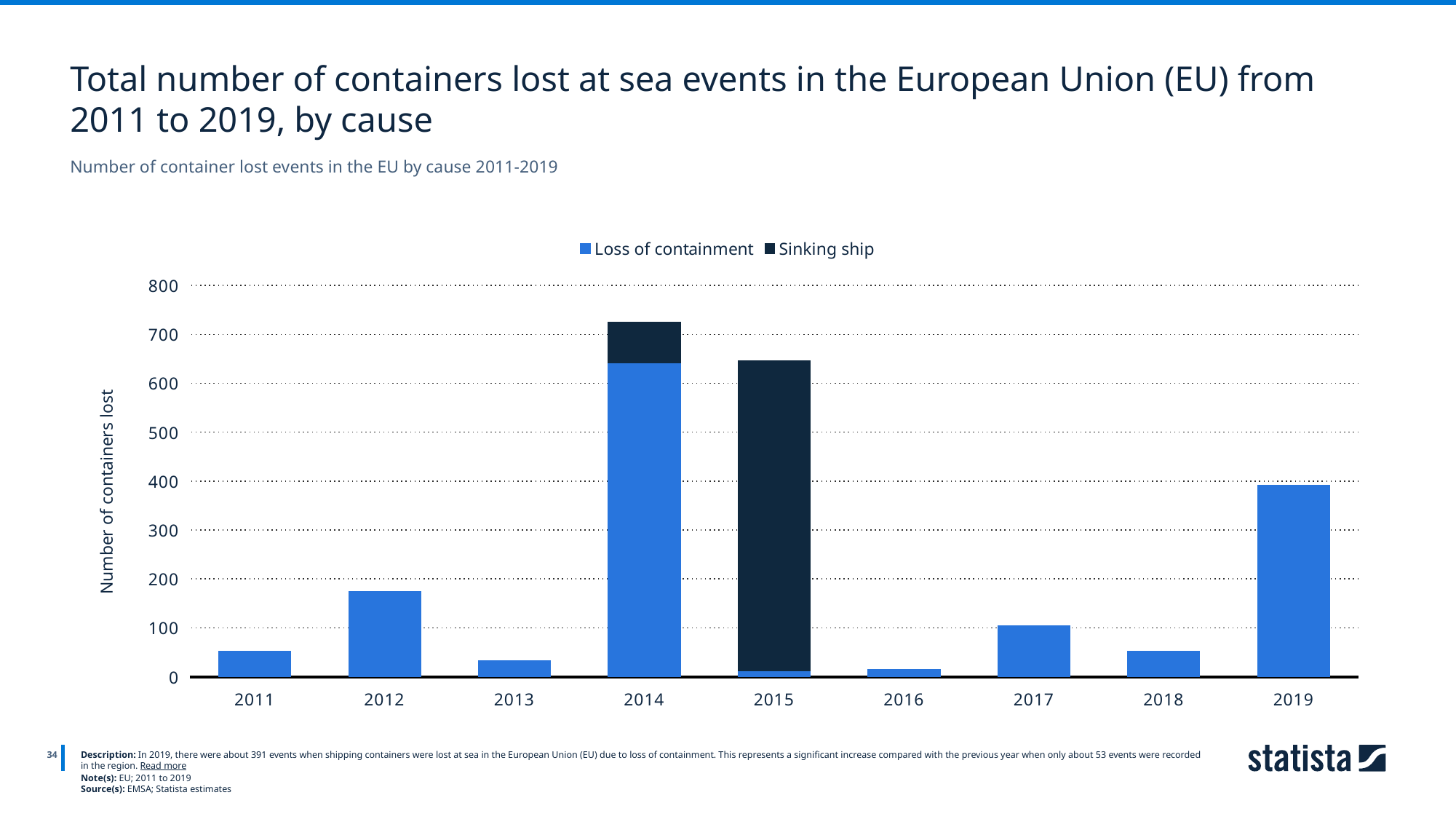
Which year has the lowest total bar? 2016 How many series does the legend list? 2 Is the value for Loss of containment in 2012 greater or less than 200? less Which is larger, the bar for 2012 or the bar for 2017? 2012 Which is larger, the total bar for 2014 or the total bar for 2015? 2014 How many years are shown on the x axis? 9 Which year has the highest total bar? 2014 Is the total bar for 2015 greater or less than 600? greater Is the value for Loss of containment in 2019 greater or less than 300? greater What is the label on the y axis? Number of containers lost Which year has the largest Sinking ship segment? 2015 What kind of chart is shown on the slide? Stacked bar chart